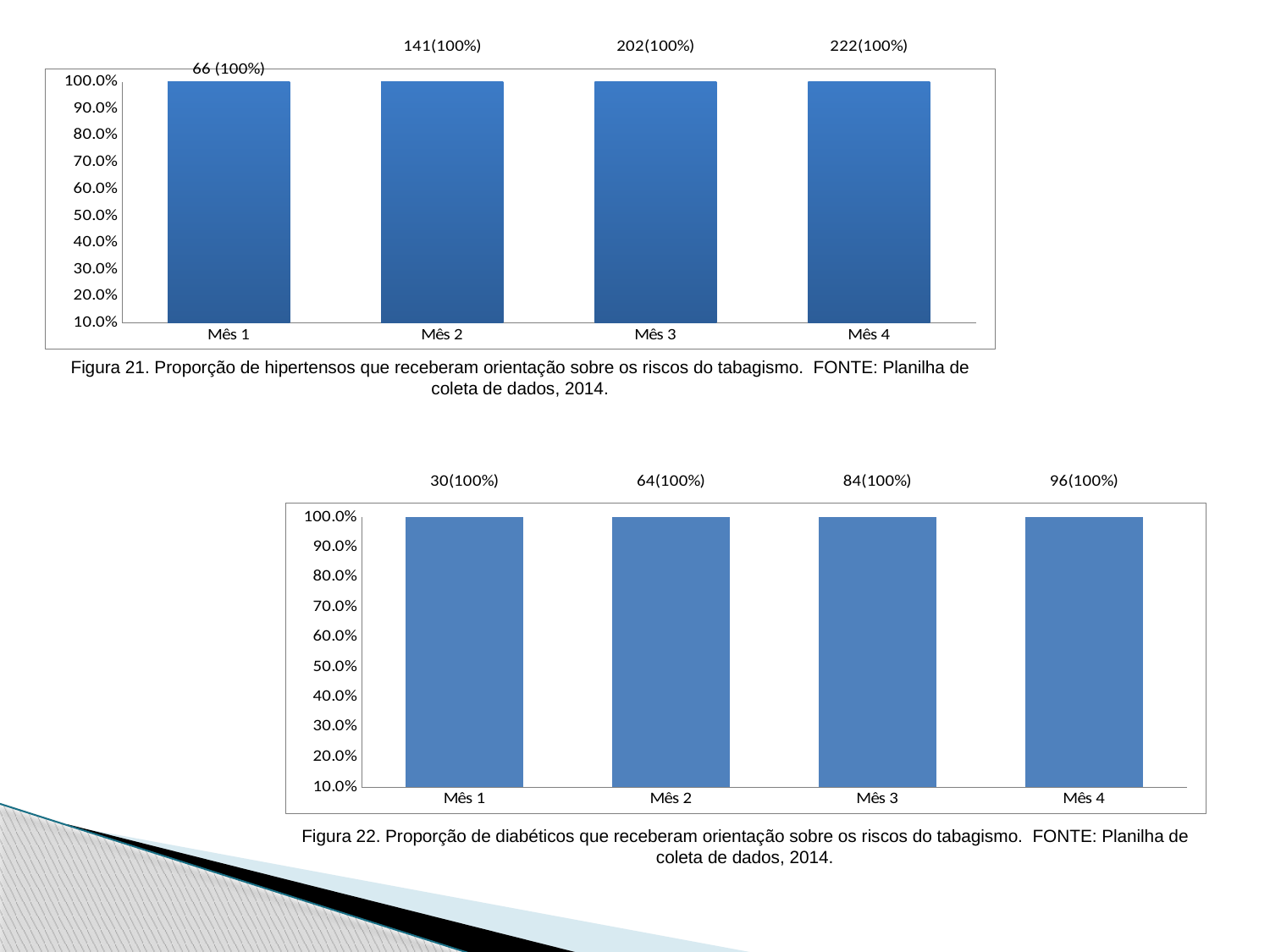
In the bottom chart (Figura 22), do the bar heights rise, fall, or stay the same from Mês 1 to Mês 4? Stay the same In the bottom chart (Figura 22), what is the data label shown above the bar for Mês 2? 64(100%) In the top chart (Figura 21), what is the data label shown above the bar for Mês 4? 222(100%) In the top chart (Figura 21), how many months (categories) are shown on the x axis? 4 In the top chart (Figura 21), what is the data label shown above the bar for Mês 1? 66 (100%) In the bottom chart (Figura 22), what is the data label shown above the bar for Mês 4? 96(100%) What kind of chart is the top chart (Figura 21)? Bar chart In the top chart (Figura 21), what is the data label shown above the bar for Mês 3? 202(100%) In the bottom chart (Figura 22), how many bars are plotted? 4 In the top chart (Figura 21), what is the difference between the number of patients labelled for Mês 4 (222) and for Mês 1 (66)? 156 According to its caption, which group of patients does the bottom chart (Figura 22) refer to? Diabéticos In the bottom chart (Figura 22), what is the difference between the number of patients labelled for Mês 3 (84) and for Mês 1 (30)? 54